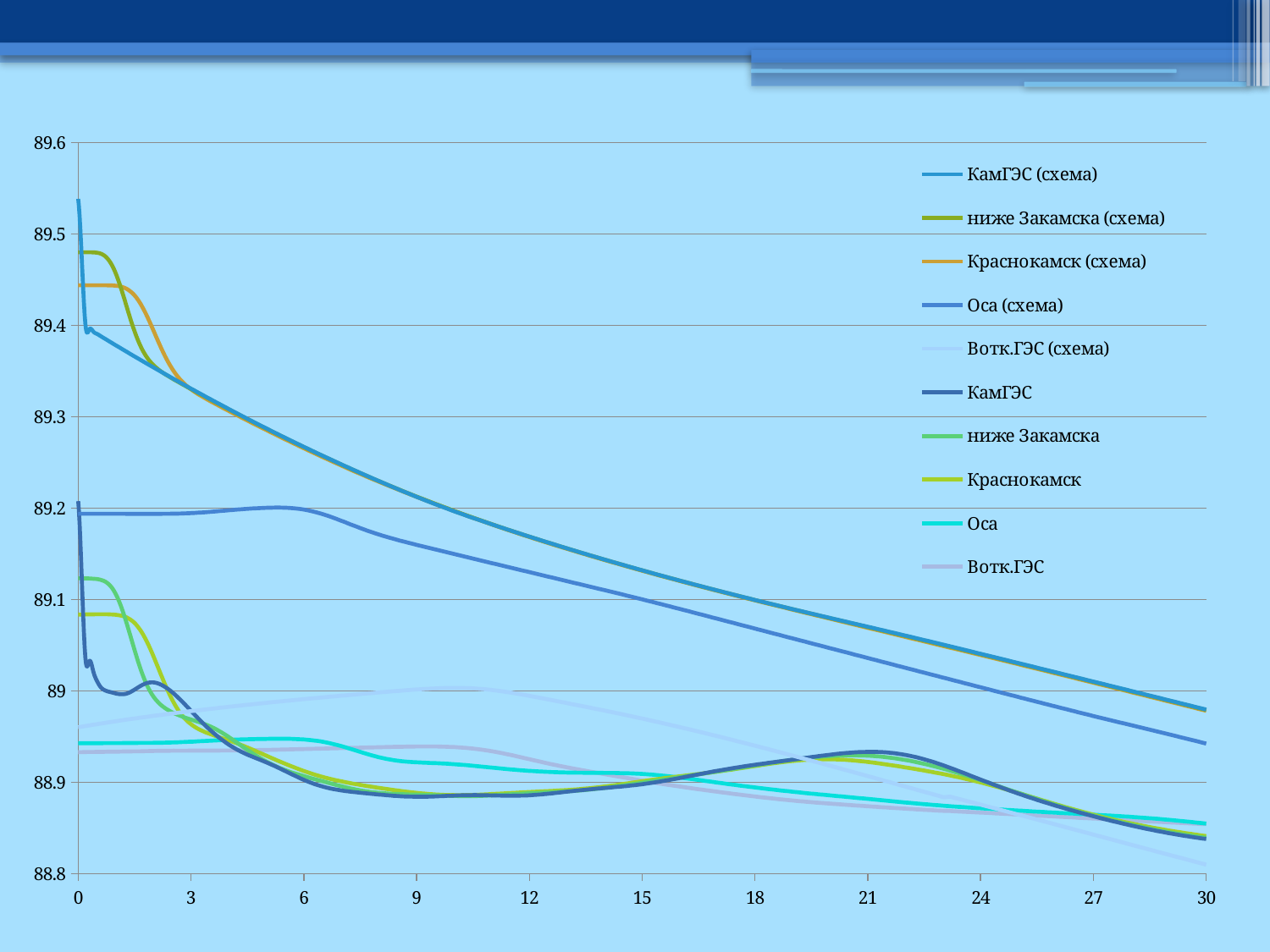
At x = 0, which series has the higher value, Оса (схема) or Оса? Оса (схема) Which series has the highest value at x = 0? КамГЭС (схема) Is the value for Вотк.ГЭС (схема) at x = 30 greater or less than 88.9? less Is the value for Оса (схема) at x = 0 greater or less than 89.1? greater Is the value for КамГЭС (схема) at x = 15 greater or less than 89.1? greater What is the highest value shown on the x axis? 30 How many of the legend entries contain the word "(схема)"? 5 How many series does the legend list? 10 At x = 30, which series has the higher value, КамГЭС (схема) or Оса (схема)? КамГЭС (схема) Does the Оса (схема) series rise or fall overall from x = 0 to x = 30? fall What kind of chart is shown on the slide? line chart